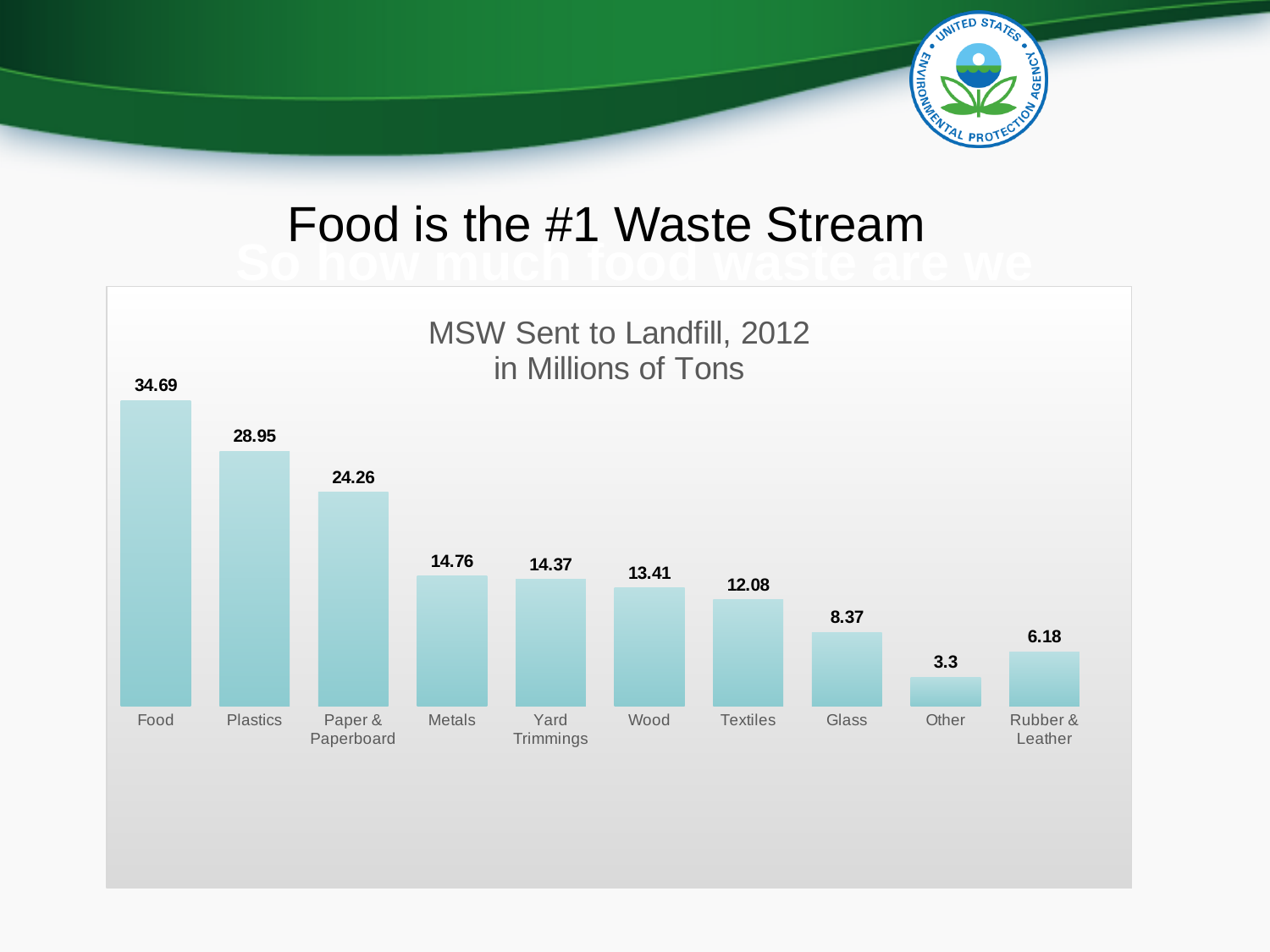
Which is larger, the value for Metals or the value for Wood? Metals Which category has the lowest value? Other What is the difference between the values for Food and Plastics? 5.74 What kind of chart is shown on the slide? Bar chart What is the value for Food in the MSW Sent to Landfill, 2012 chart? 34.69 What is the title of the chart? MSW Sent to Landfill, 2012 in Millions of Tons How many categories are shown in the chart? 10 What is the difference between the values for Glass and Other? 5.07 Which category has the highest value? Food Which is larger, the value for Textiles or the value for Paper & Paperboard? Paper & Paperboard What is the value for Rubber & Leather? 6.18 What is the value for Yard Trimmings? 14.37